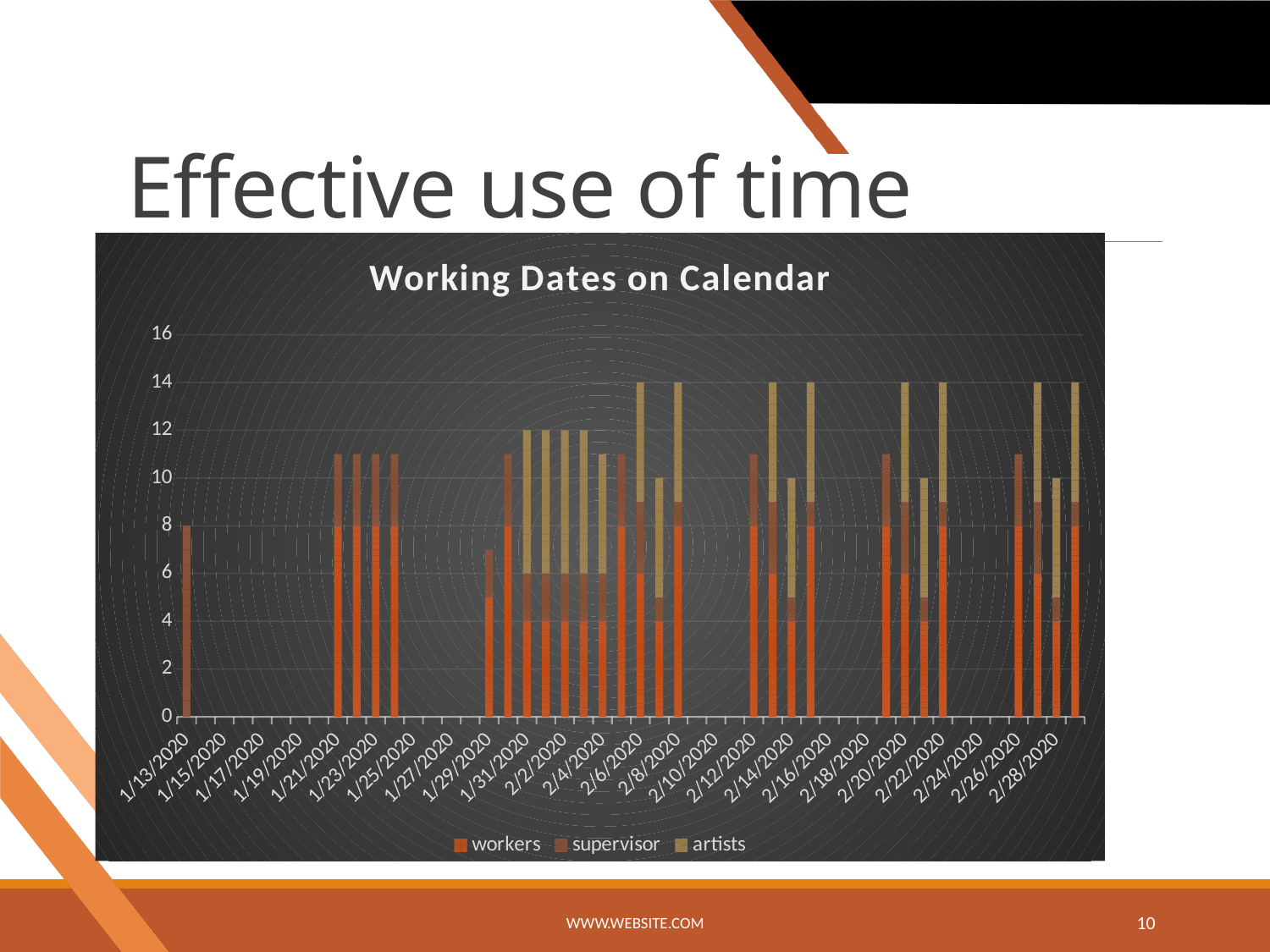
What is the title of the chart? Working Dates on Calendar Is the total value for 1/13/2020 greater or less than 6? greater Is the total value for 1/23/2020 greater or less than 10? greater Is the total value for 1/13/2020 greater or less than 10? less What is the highest total reached by any stacked bar on the chart? 14 How many series does the legend list? 3 What are the three series named in the legend? workers, supervisor, artists What kind of chart is shown on the slide? bar chart